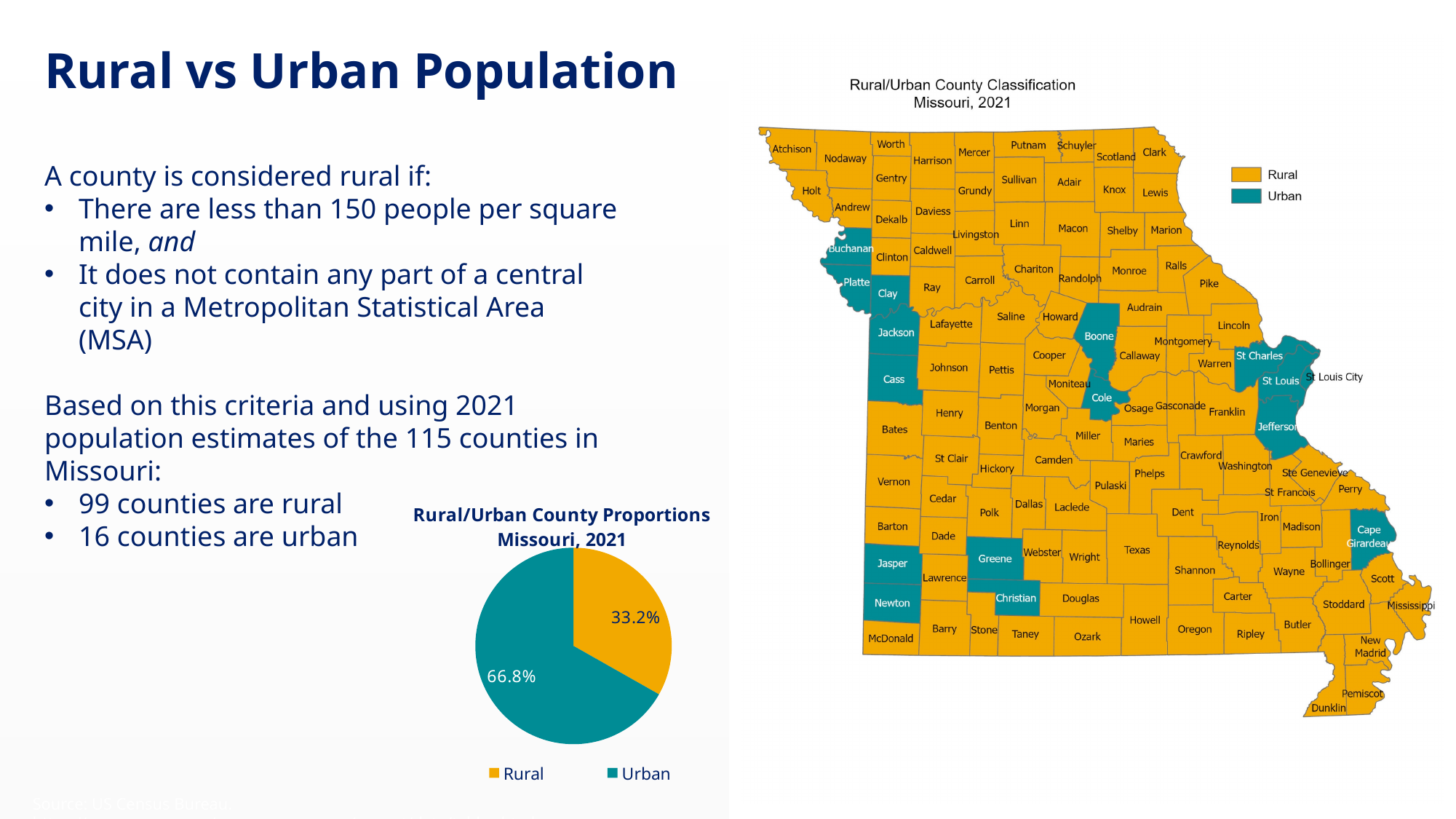
How many slices does the Rural/Urban County Proportions pie chart have? 2 In the Rural/Urban County Proportions pie chart, which slice is the smallest? Rural In the Rural/Urban County Proportions pie chart, what is the difference between the Urban and Rural percentages? 33.6% How many entries does the legend of the Rural/Urban County Proportions chart list? 2 In the Rural/Urban County Classification map, which colour represents Urban counties? teal What kind of chart is the Rural/Urban County Proportions chart? pie chart In the Rural/Urban County Proportions pie chart, what percentage is shown on the Rural slice? 33.2% In the Rural/Urban County Proportions pie chart, which slice is the largest? Urban In the Rural/Urban County Proportions pie chart, what percentage is shown on the Urban slice? 66.8% What is the title of the pie chart on the slide? Rural/Urban County Proportions Missouri, 2021 In the Rural/Urban County Proportions pie chart, is the Urban share greater or less than 50%? greater In the Rural/Urban County Proportions pie chart, is the Urban slice larger or smaller than the Rural slice? larger